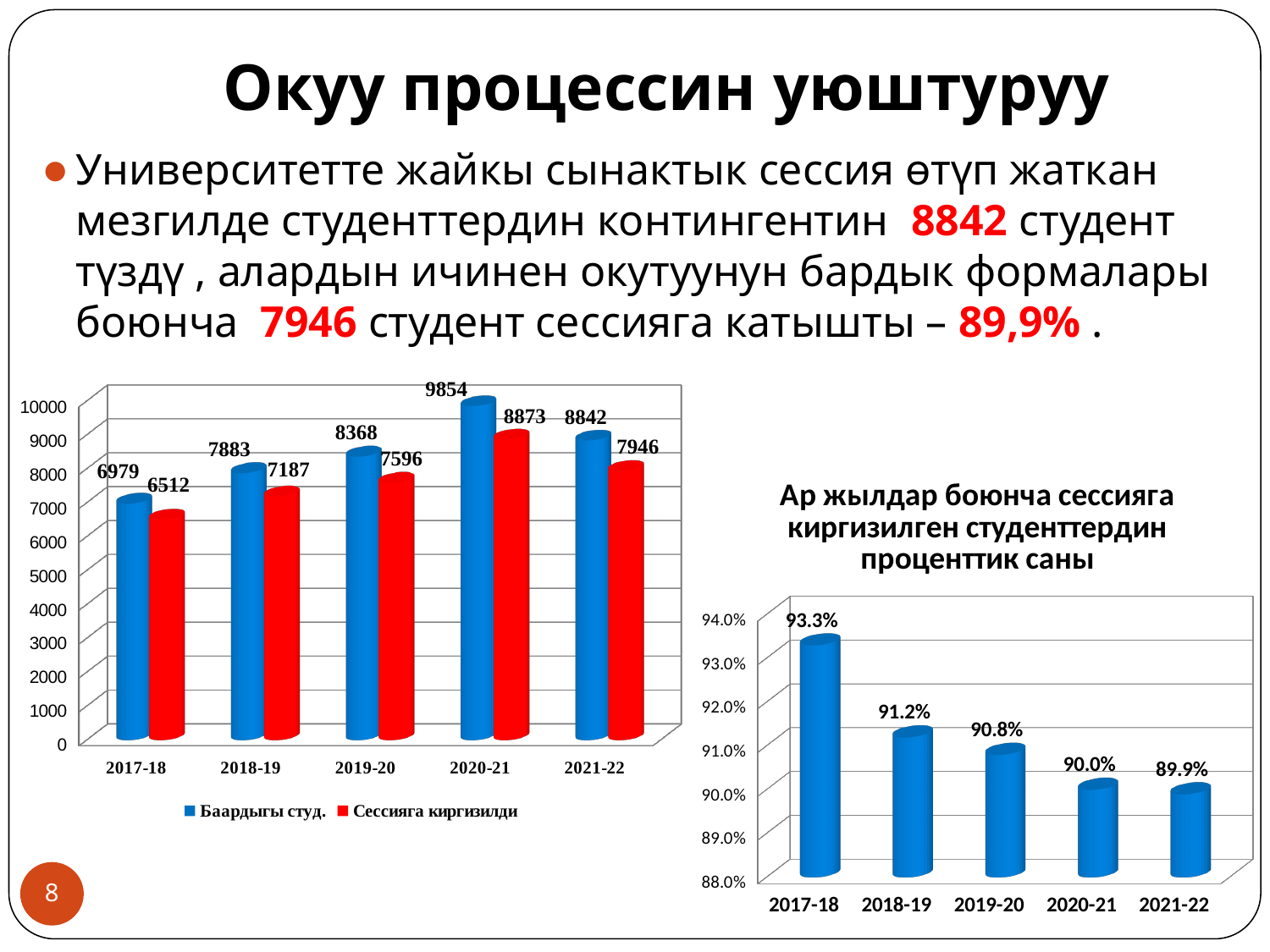
In the left chart, what is the difference between 'Баардыгы студ.' and 'Сессияга киргизилди' for 2021-22? 896 In the left chart, what is the value of 'Сессияга киргизилди' for 2018-19? 7187 How many series does the legend of the left chart list? 2 How many years are shown on the x axis of the right chart? 5 In the chart titled 'Ар жылдар боюнча сессияга киргизилген студенттердин проценттик саны', which year has the highest value? 2017-18 What kind of chart is the right chart? bar chart In the left chart, what is the value of 'Баардыгы студ.' for 2020-21? 9854 In the chart titled 'Ар жылдар боюнча сессияга киргизилген студенттердин проценттик саны', do the values rise or fall from 2017-18 to 2021-22? fall In the left chart, which year has the highest value for 'Баардыгы студ.'? 2020-21 In the left chart, which year has the lowest value for 'Сессияга киргизилди'? 2017-18 In the chart titled 'Ар жылдар боюнча сессияга киргизилген студенттердин проценттик саны', what is the value for 2019-20? 90.8% In the left chart, which is larger: 'Сессияга киргизилди' for 2019-20 or 'Баардыгы студ.' for 2017-18? Сессияга киргизилди for 2019-20